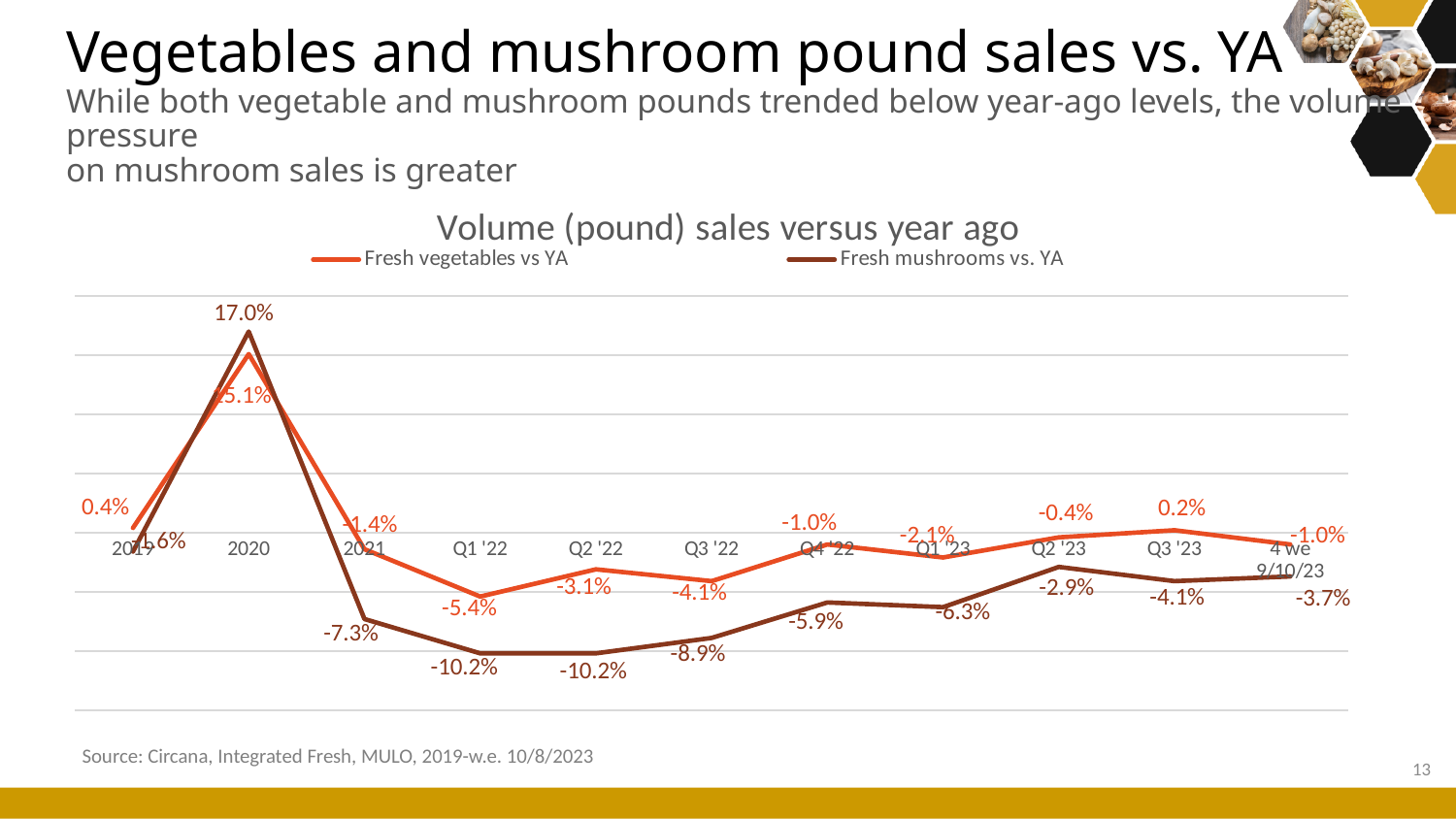
In which period is the Fresh vegetables vs YA value lowest? Q1 '22 What is the value for Fresh vegetables vs YA for the 4 we 9/10/23 period? -1.0% In Q2 '23, which series has the higher value, Fresh vegetables vs YA or Fresh mushrooms vs. YA? Fresh vegetables vs YA What is the title of the chart? Volume (pound) sales versus year ago What is the difference between the Fresh vegetables vs YA and Fresh mushrooms vs. YA values in Q3 '23? 4.3 percentage points How many series does the legend list? 2 What kind of chart is shown on the slide? line chart In which period is the Fresh mushrooms vs. YA value highest? 2020 What is the value for Fresh vegetables vs YA in Q1 '22? -5.4% What is the value for Fresh mushrooms vs. YA in Q3 '22? -8.9% What is the value for Fresh mushrooms vs. YA in 2020? 17.0% How many time periods are plotted along the x axis? 11